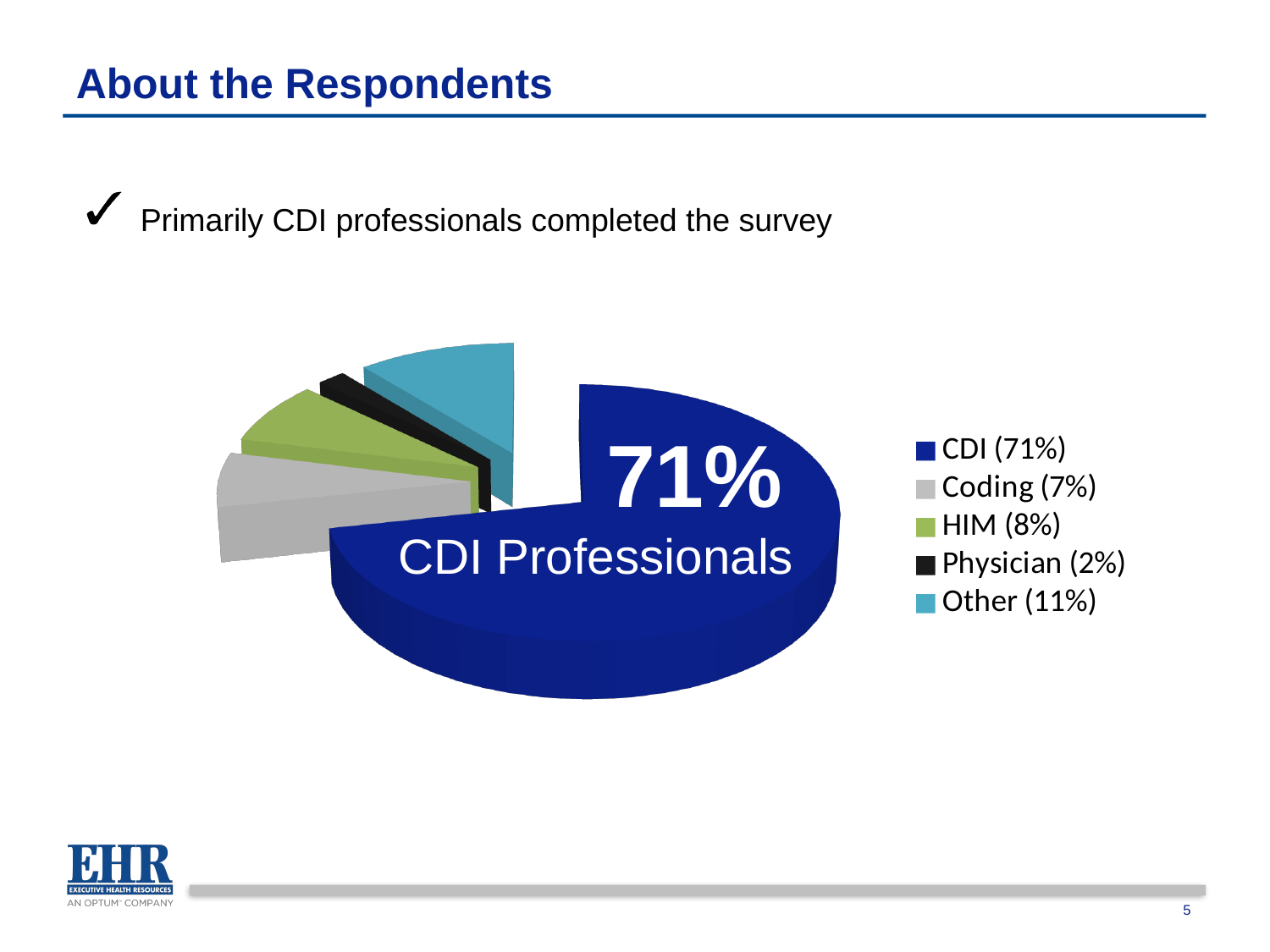
What percentage of respondents are in the Coding category? 7% How many categories does the pie chart show? 5 What percentage of respondents are in the HIM category? 8% Which category has the largest share of respondents? CDI What kind of chart is shown on the slide? Pie chart Which is larger, the HIM share or the Coding share? HIM What colour is the CDI slice in the pie chart? Dark blue What share of respondents are CDI professionals? 71% What percentage of respondents are Physicians? 2% What percentage of respondents fall into the Other category? 11% What is the difference in percentage points between the CDI share and the Other share? 60 Which category has the smallest share of respondents? Physician